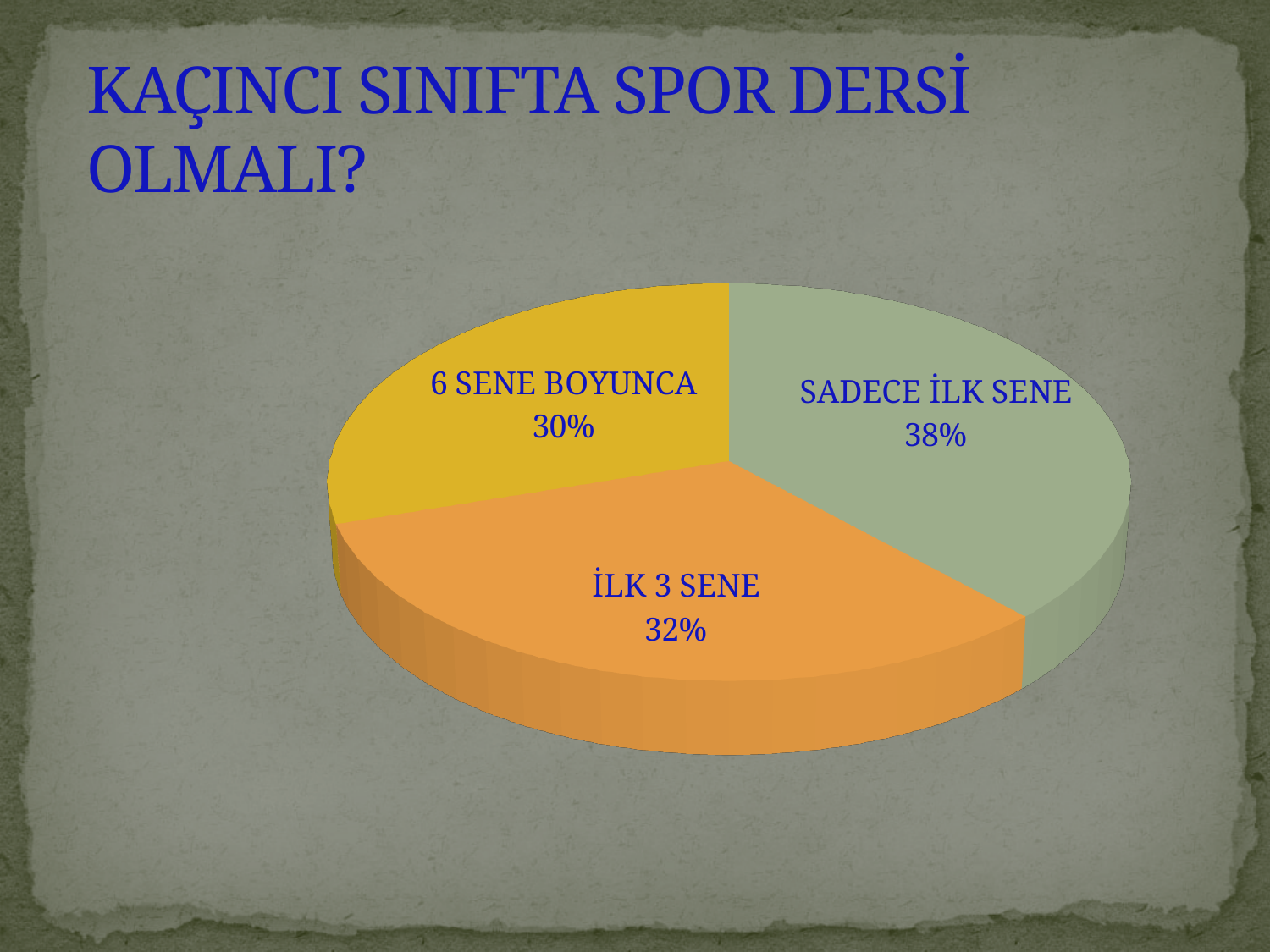
What share of the pie does "SADECE İLK SENE" have? 38% What kind of chart is shown on the slide? pie chart Which is larger, the share for "SADECE İLK SENE" or the share for "İLK 3 SENE"? SADECE İLK SENE What is the difference in percentage points between "SADECE İLK SENE" and "6 SENE BOYUNCA"? 8 What colour is the "İLK 3 SENE" slice of the pie? orange How many slices does the pie chart have? 3 What is the title of the slide containing the pie chart? KAÇINCI SINIFTA SPOR DERSİ OLMALI? Which slice of the pie is the largest? SADECE İLK SENE What is the difference in percentage points between "İLK 3 SENE" and "6 SENE BOYUNCA"? 2 What share of the pie does "İLK 3 SENE" have? 32% Which slice of the pie is the smallest? 6 SENE BOYUNCA What share of the pie does "6 SENE BOYUNCA" have? 30%